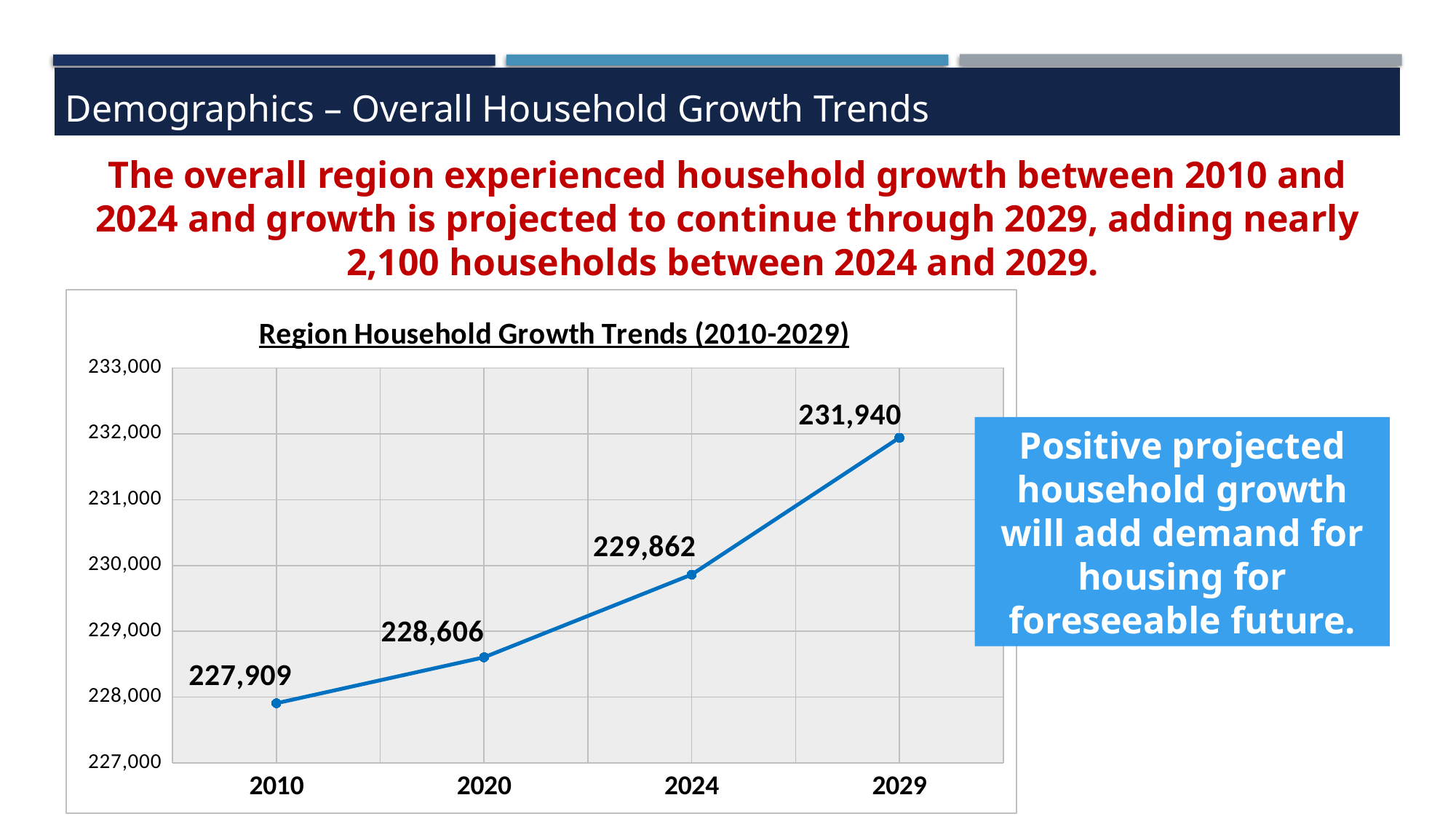
What is the number of households in 2024? 229,862 Do household counts rise or fall from 2010 to 2029? Rise What type of chart is shown? Line chart Which year has the lowest household count? 2010 What is the difference in households between 2010 and 2020? 697 What is the projected number of households in 2029? 231,940 What is the number of households in 2020? 228,606 What is the number of households in 2010? 227,909 Which year has more households, 2020 or 2024? 2024 How many data points are plotted on the chart? 4 Which year has the highest household count? 2029 What is the difference in households between 2024 and 2029? 2,078